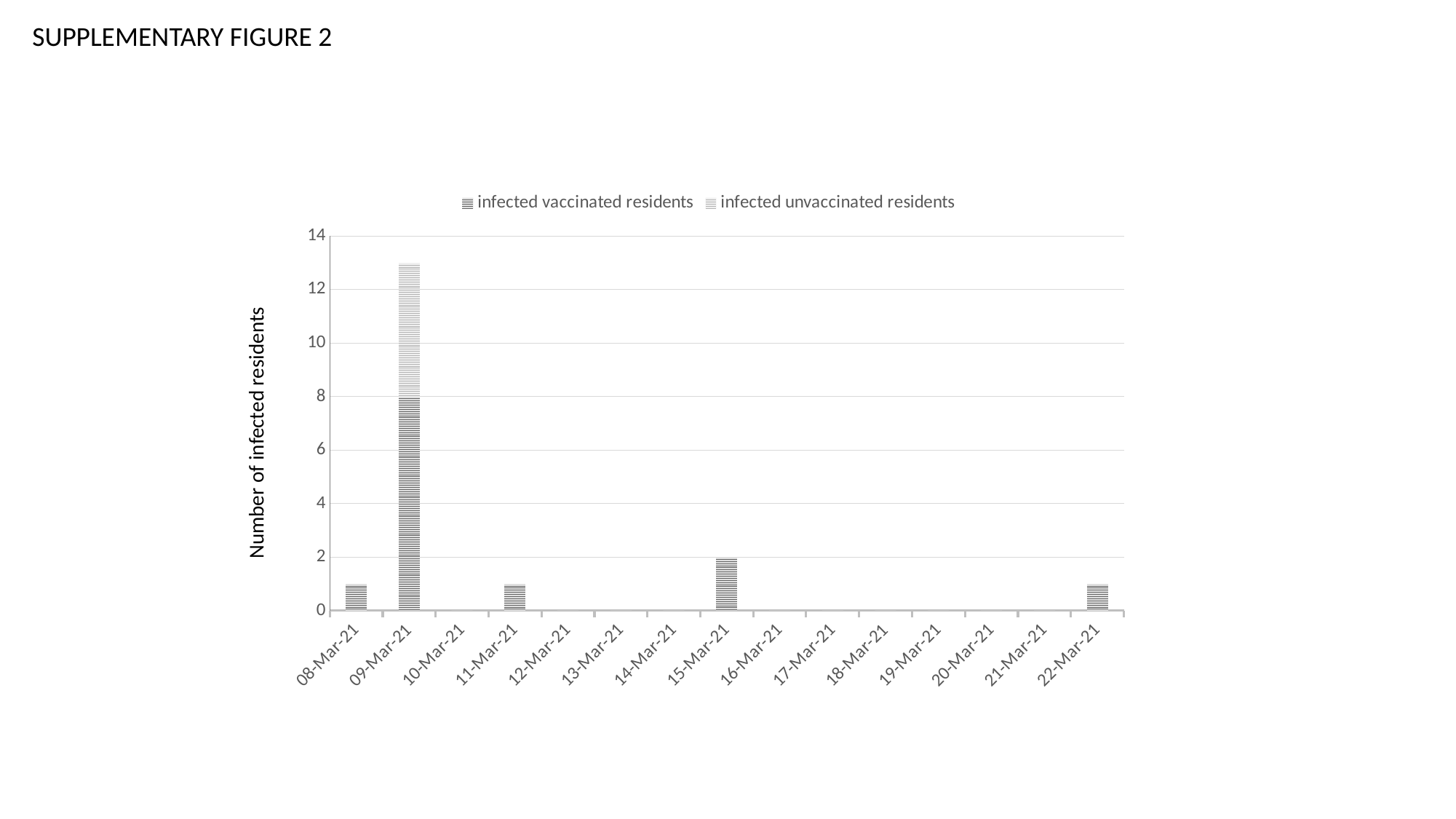
Is the total number of infected residents on 09-Mar-21 greater or less than 12? greater Which date has more infected residents, 09-Mar-21 or 15-Mar-21? 09-Mar-21 Is the number of infected vaccinated residents on 09-Mar-21 greater or less than 6? greater Which date has the highest number of infected residents? 09-Mar-21 How many series does the legend list? 2 What are the two series named in the legend? infected vaccinated residents; infected unvaccinated residents What is the title of the y axis? Number of infected residents What kind of chart is shown on the slide? bar chart What is the number of infected residents on 15-Mar-21? 2 How many dates are shown on the x axis? 15 Is the number of infected residents on 08-Mar-21 greater or less than 2? less Which date has more infected residents, 11-Mar-21 or 15-Mar-21? 15-Mar-21